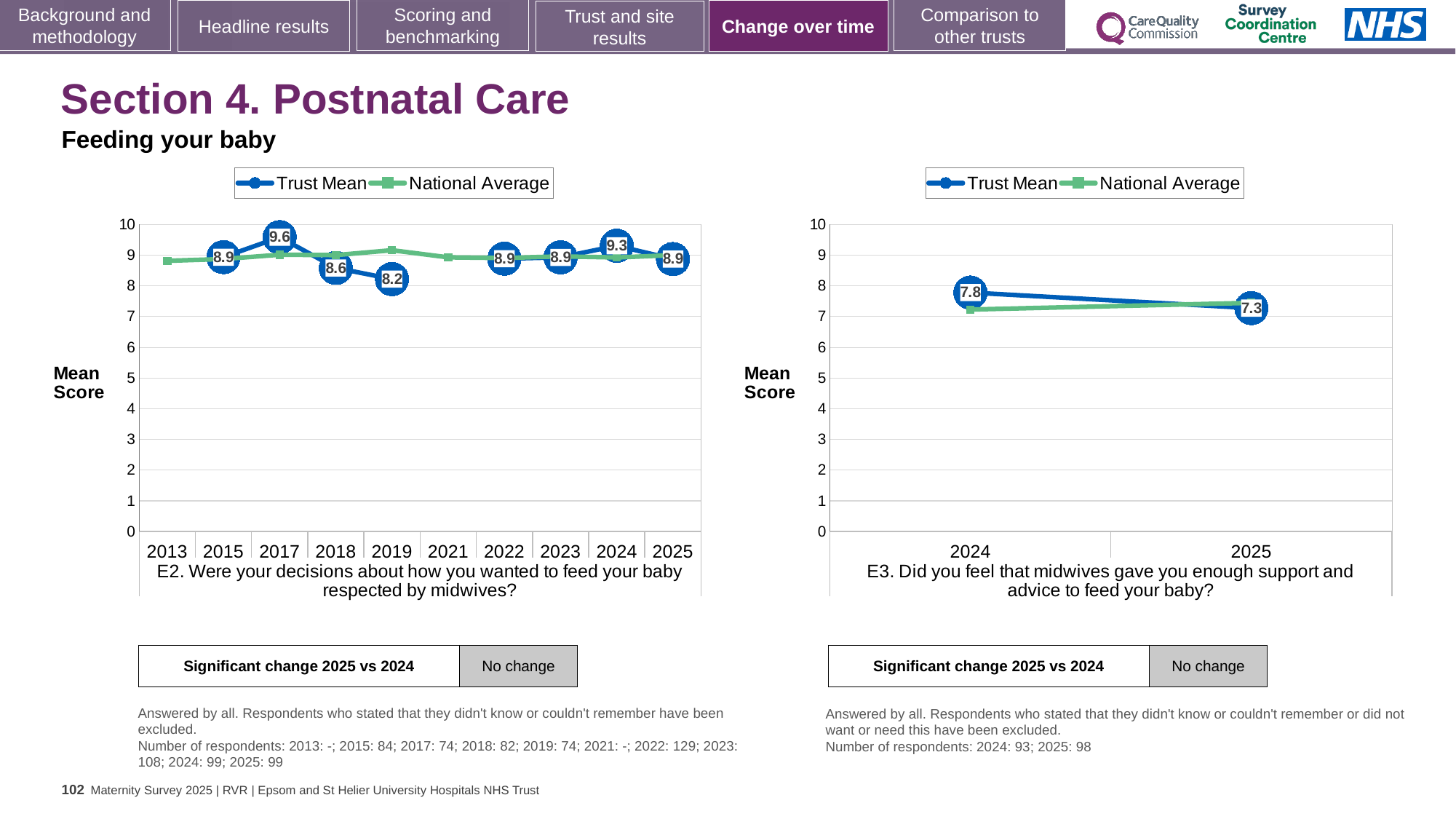
What kind of chart is the right chart (E3)? Line chart In the left chart (E2), which year has the highest Trust Mean? 2017 In the left chart (E2), which year has the lowest Trust Mean? 2019 How many years are shown on the x axis of the left chart (E2)? 10 In the left chart (E2), what is the Trust Mean for 2019? 8.2 In the right chart (E3), is the National Average for 2024 greater or less than 8? less In the left chart (E2), which is larger, the Trust Mean for 2024 or for 2018? 2024 How many series does the legend of the right chart (E3) list? 2 In the left chart (E2), what is the difference between the Trust Mean in 2017 and in 2019? 1.4 In the right chart (E3), what is the difference between the Trust Mean in 2024 and in 2025? 0.5 In the right chart (E3), what is the Trust Mean for 2025? 7.3 In the left chart (E2), what is the Trust Mean for 2017? 9.6